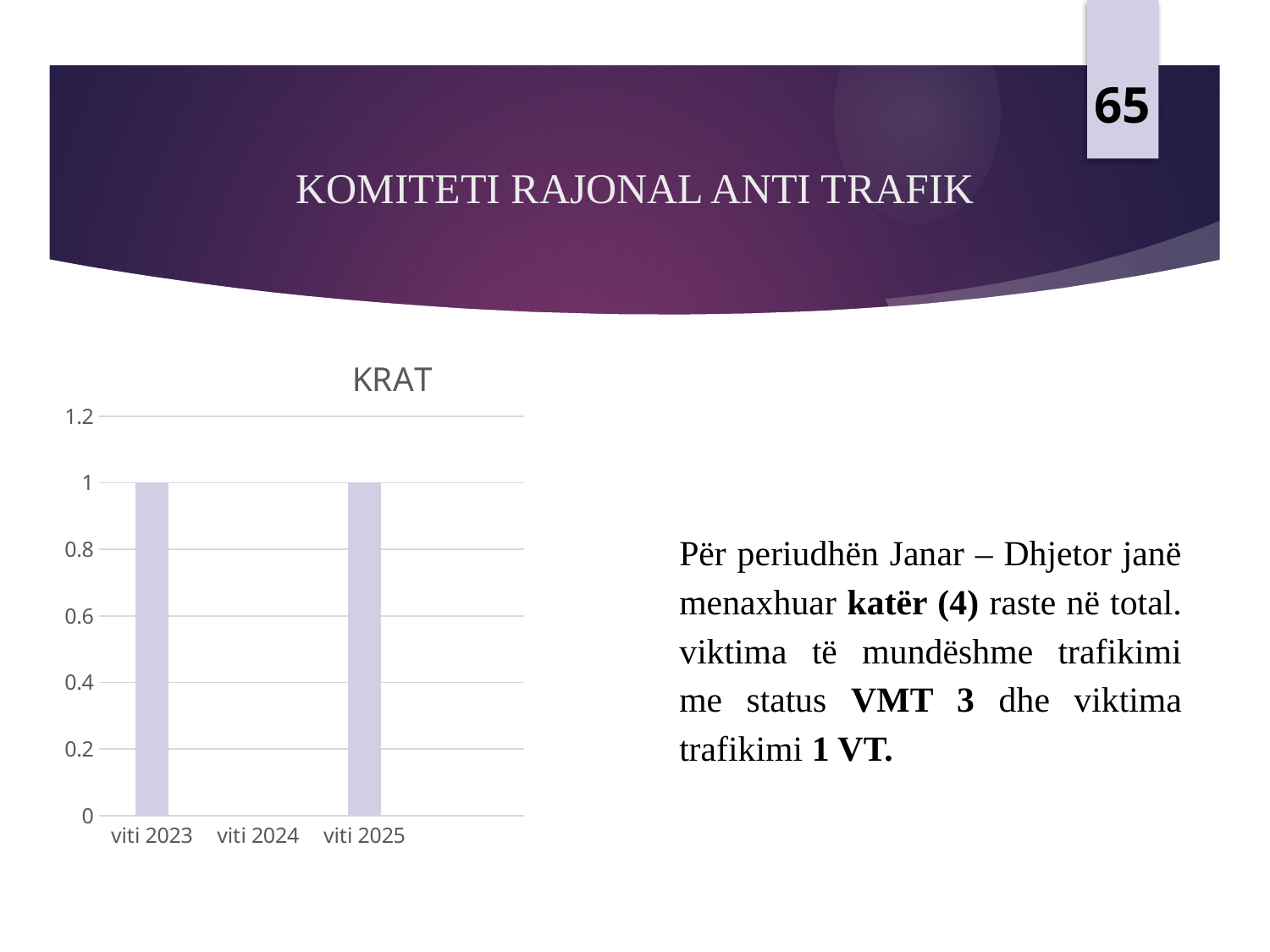
Which is larger in the KRAT chart, the value for viti 2023 or viti 2024? viti 2023 What kind of chart is shown on the slide? bar chart Is the value for viti 2025 greater or less than 1.2? less Which category in the KRAT chart has no visible bar? viti 2024 Which is larger in the KRAT chart, the value for viti 2025 or viti 2024? viti 2025 How many categories are shown on the x axis of the KRAT chart? 3 What is the value for viti 2025 in the KRAT chart? 1 What is the title of the chart? KRAT Is the value for viti 2023 greater or less than 0.8? greater What is the value for viti 2023 in the KRAT chart? 1 What is the difference between the values for viti 2023 and viti 2025 in the KRAT chart? 0